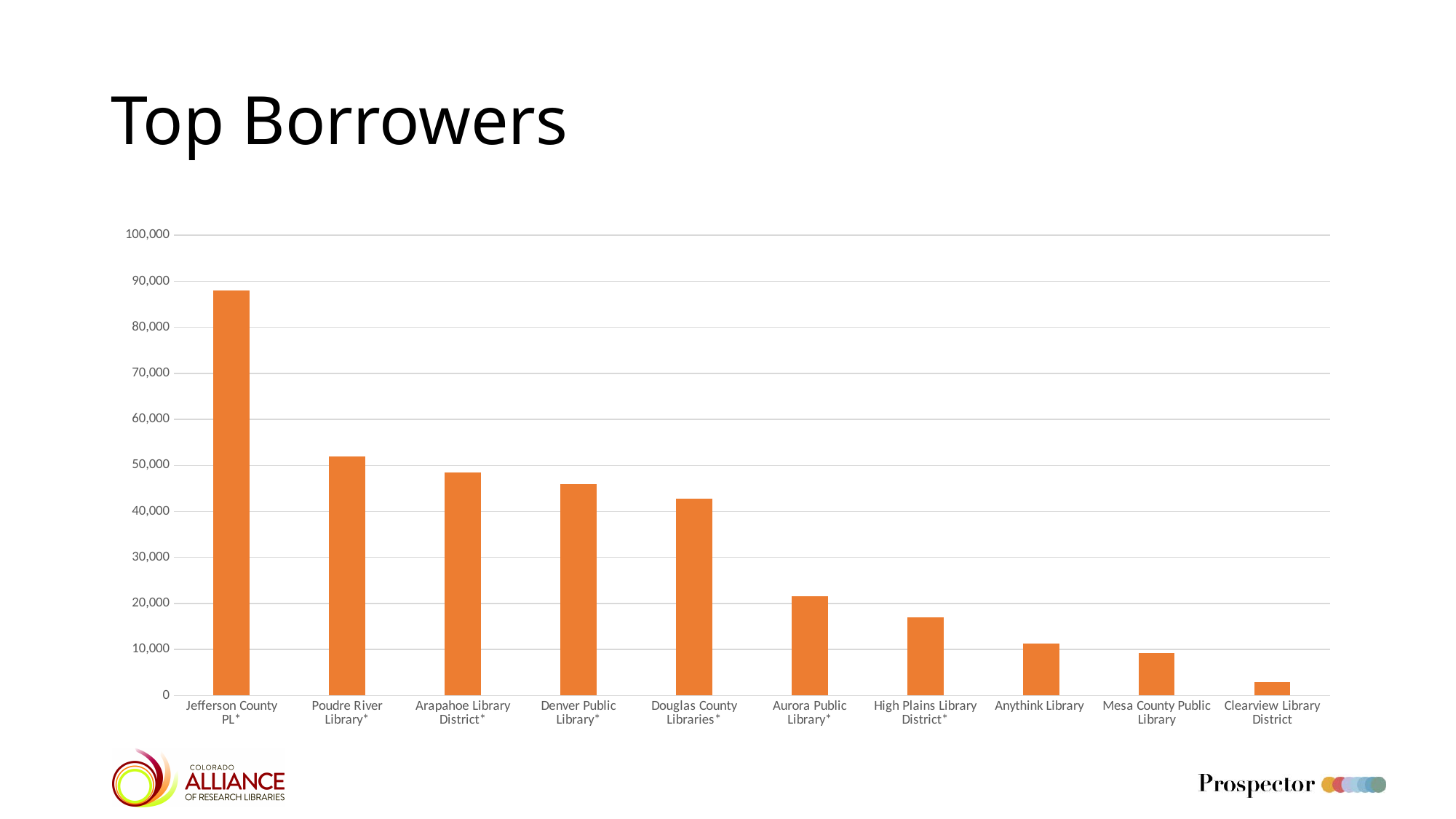
How many libraries are shown in the Top Borrowers chart? 10 Is the value for Clearview Library District greater or less than 10,000? less Which library has the highest value in the Top Borrowers chart? Jefferson County PL* Which is larger, the value for Poudre River Library* or the value for Denver Public Library*? Poudre River Library* Is the value for High Plains Library District* greater or less than 20,000? less What is the title of the slide containing the chart? Top Borrowers Is the value for Denver Public Library* greater or less than 50,000? less Do the values rise or fall moving from left to right along the x axis? fall Which is larger, the value for Aurora Public Library* or the value for Anythink Library? Aurora Public Library* Which library has the lowest value in the Top Borrowers chart? Clearview Library District What kind of chart is shown on the slide? bar chart